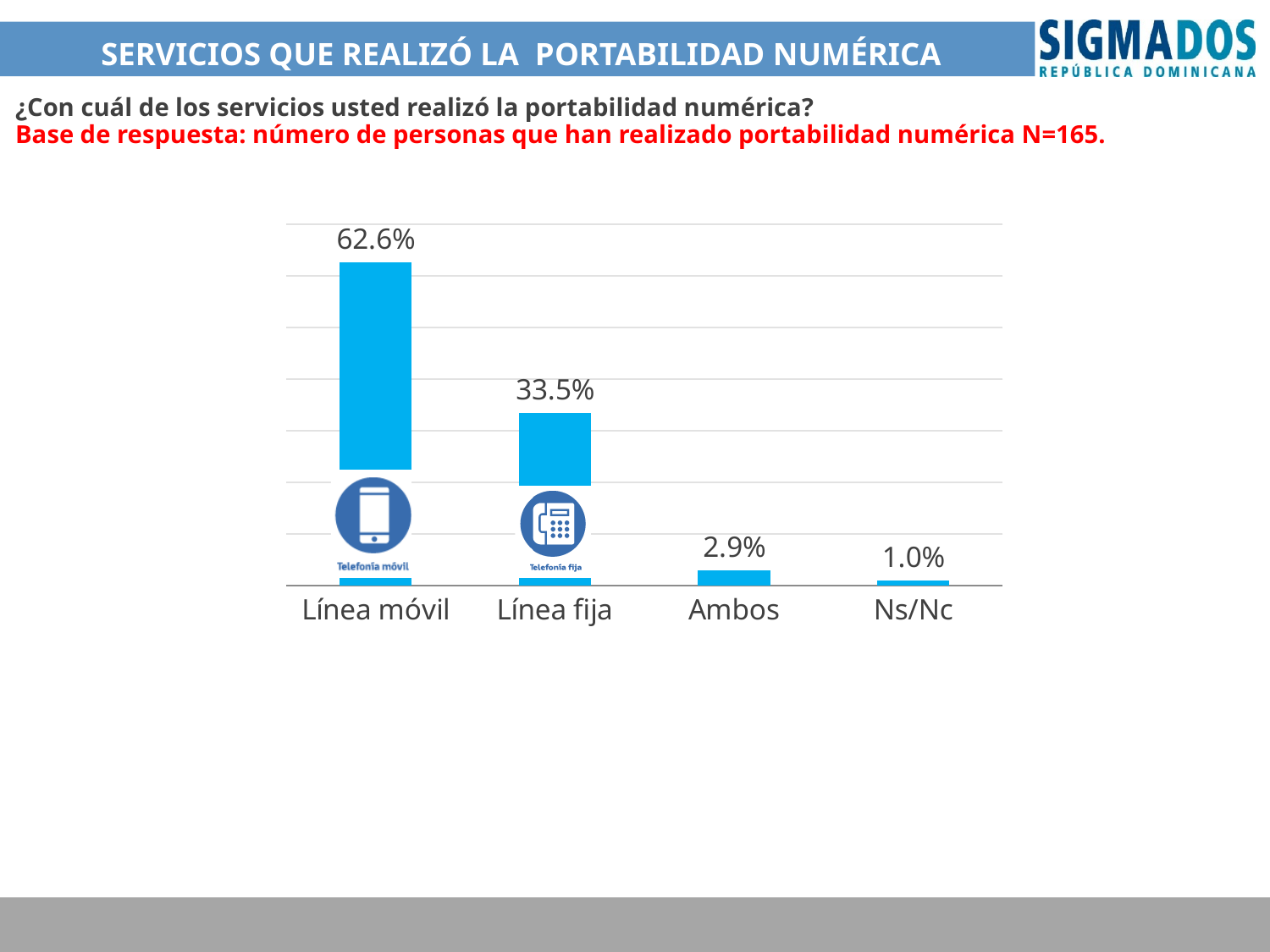
Which category has the lowest value? Ns/Nc What is the value for Línea fija? 33.5% How many categories are shown on the x axis? 4 What is the value for Ambos? 2.9% What is the difference between the values for Línea móvil and Línea fija? 29.1% What is the base (N) of respondents stated on the slide? N=165 Which is larger, the value for Ambos or the value for Ns/Nc? Ambos What kind of chart is shown on the slide? Bar chart What is the value for Ns/Nc? 1.0% Which category has the highest value? Línea móvil What is the value for Línea móvil? 62.6% Do the values rise or fall from left to right along the x axis? Fall